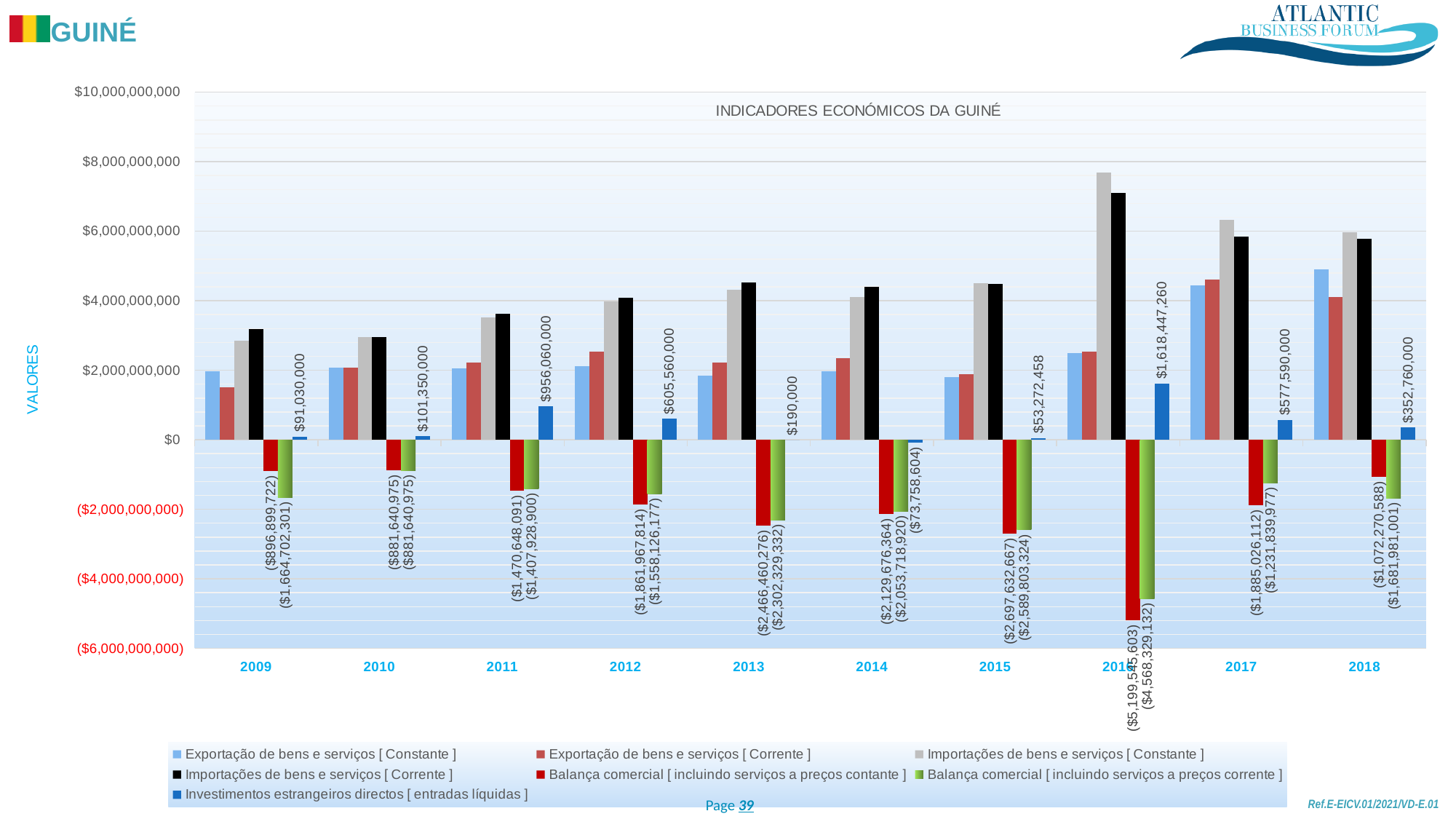
What is the value of Investimentos estrangeiros directos [entradas líquidas] in 2016? $1,618,447,260 What kind of chart is shown on the slide? bar chart What is the title of the chart? INDICADORES ECONÓMICOS DA GUINÉ In which year is Investimentos estrangeiros directos [entradas líquidas] highest? 2016 What is the value of Balança comercial [incluindo serviços a preços contante] in 2016? ($5,199,545,603) How many series does the chart legend list? 7 In which year is Investimentos estrangeiros directos [entradas líquidas] lowest? 2014 What is the value of Investimentos estrangeiros directos [entradas líquidas] in 2013? $190,000 Is the value of Importações de bens e serviços [Constante] in 2016 greater or less than $6,000,000,000? greater What is the difference between Investimentos estrangeiros directos [entradas líquidas] in 2011 and in 2012? $350,500,000 How many years are shown on the x axis of the chart? 10 Which year has the larger value of Investimentos estrangeiros directos [entradas líquidas], 2011 or 2017? 2011